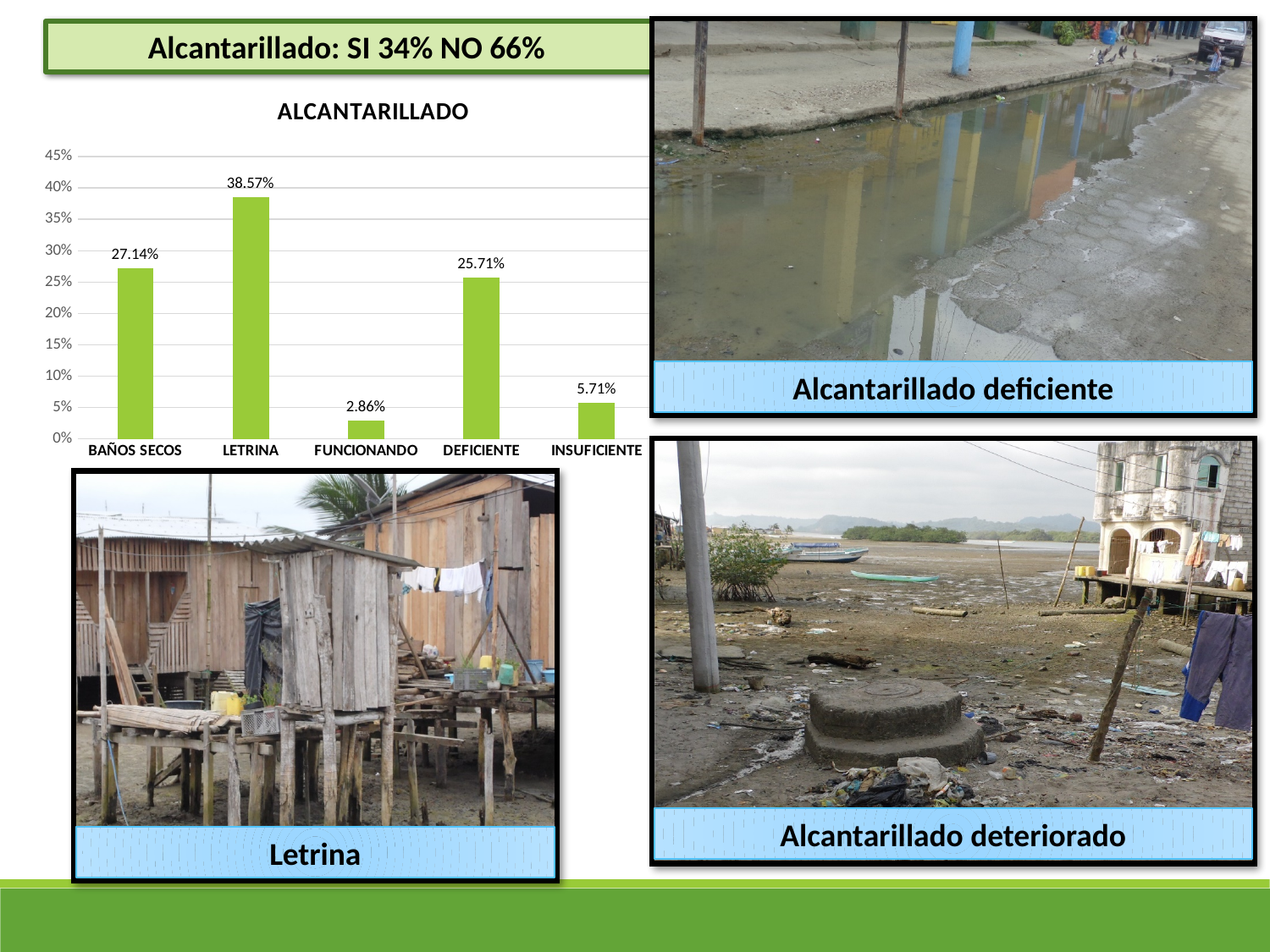
What is the value for BAÑOS SECOS in the ALCANTARILLADO chart? 27.14% How many categories are shown in the ALCANTARILLADO chart? 5 What is the value for LETRINA in the ALCANTARILLADO chart? 38.57% Which category has the highest value in the ALCANTARILLADO chart? LETRINA What is the value for FUNCIONANDO in the ALCANTARILLADO chart? 2.86% Which category has the lowest value in the ALCANTARILLADO chart? FUNCIONANDO What is the value for INSUFICIENTE in the ALCANTARILLADO chart? 5.71% Which is larger in the ALCANTARILLADO chart, BAÑOS SECOS or DEFICIENTE? BAÑOS SECOS What is the title of the chart on the slide? ALCANTARILLADO What is the value for DEFICIENTE in the ALCANTARILLADO chart? 25.71% What kind of chart is the ALCANTARILLADO chart? Bar chart What is the difference between the values for LETRINA and DEFICIENTE in the ALCANTARILLADO chart? 12.86%